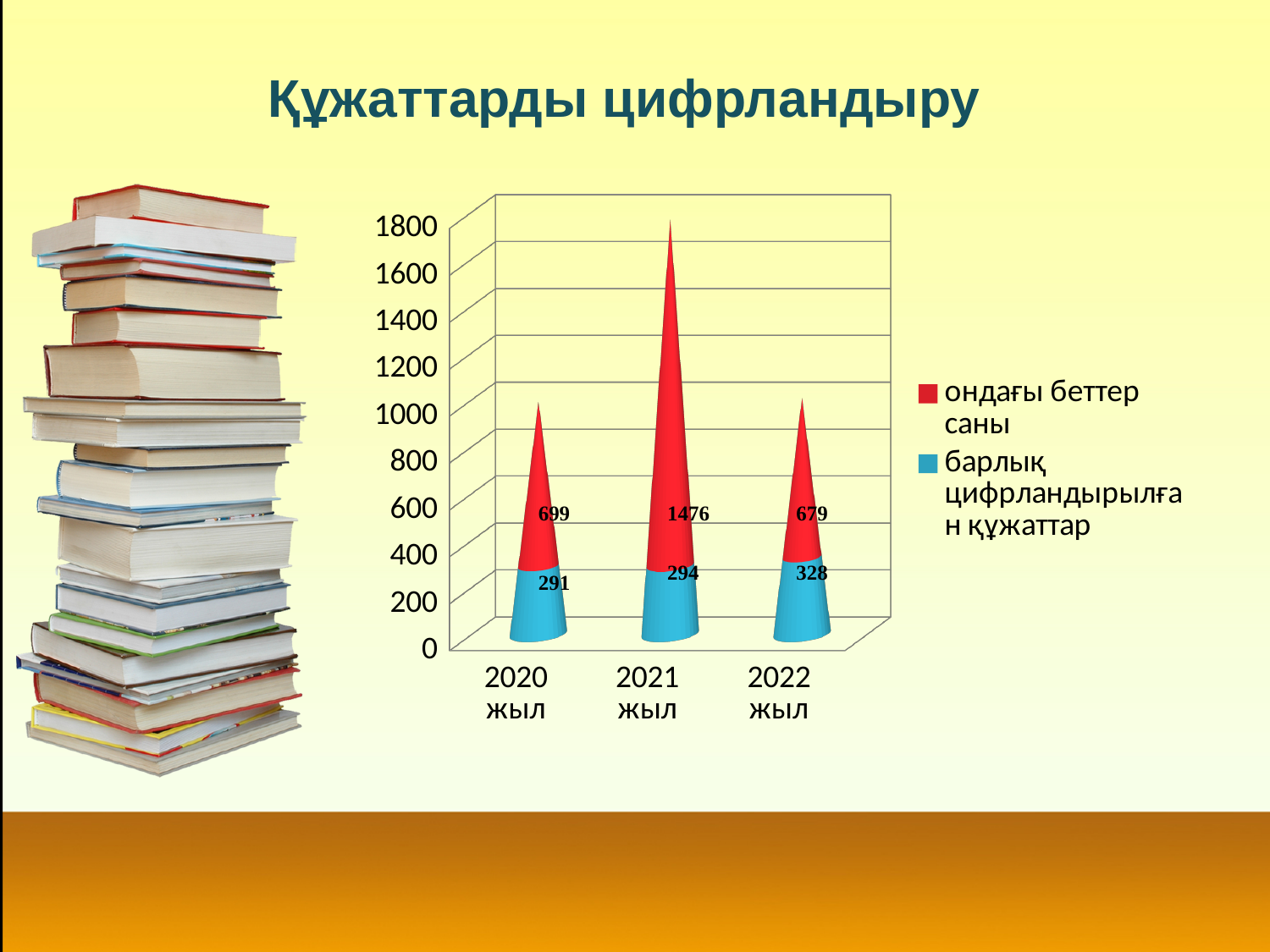
What is the value of 'барлық цифрландырылған құжаттар' for 2022 жыл? 328 Which year has the lowest value for 'барлық цифрландырылған құжаттар'? 2020 жыл Which year has the highest value for 'ондағы беттер саны'? 2021 жыл How many series does the legend list? 2 Which is larger: 'ондағы беттер саны' for 2020 жыл or for 2022 жыл? 2020 жыл What is the value of 'ондағы беттер саны' for 2020 жыл? 699 What is the total of the stacked bar for 2022 жыл? 1007 What kind of chart is shown on the slide? Stacked bar chart What is the difference between the 'ондағы беттер саны' values for 2021 жыл and 2020 жыл? 777 What is the value of 'ондағы беттер саны' for 2021 жыл? 1476 How many years are shown on the x axis? 3 What is the total of the stacked bar for 2021 жыл? 1770